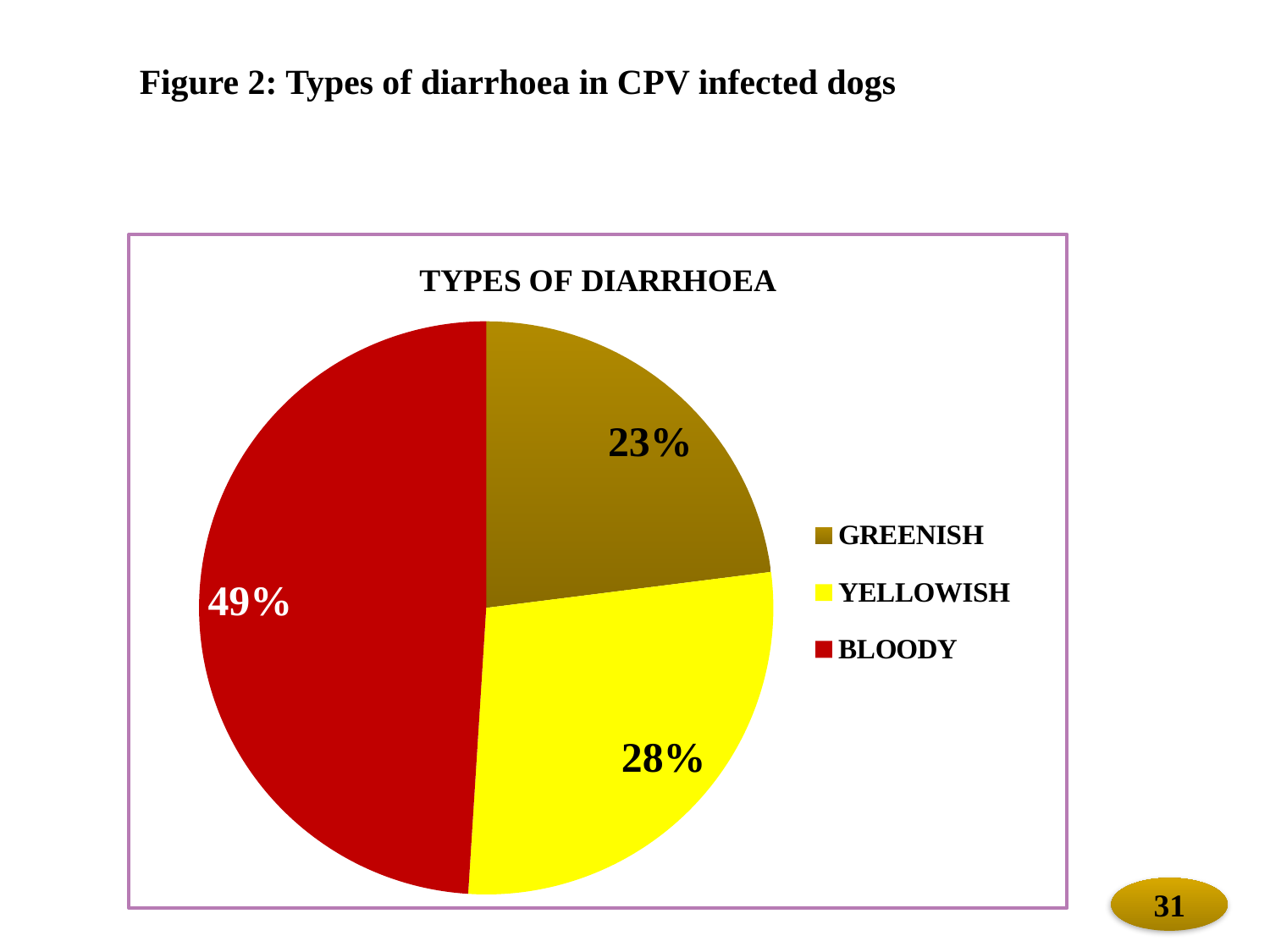
What share of the pie is YELLOWISH diarrhoea? 28% Which type of diarrhoea has the smallest share? GREENISH What colour represents BLOODY diarrhoea in the chart? red What type of chart is shown on the slide? pie chart What share of the pie is BLOODY diarrhoea? 49% Which is larger, the YELLOWISH share or the GREENISH share? YELLOWISH What is the chart's title? TYPES OF DIARRHOEA How many categories does the pie chart show? 3 What share of the pie is GREENISH diarrhoea? 23% Which type of diarrhoea has the largest share? BLOODY What is the difference in percentage points between the BLOODY and YELLOWISH shares? 21 How many entries does the legend list? 3